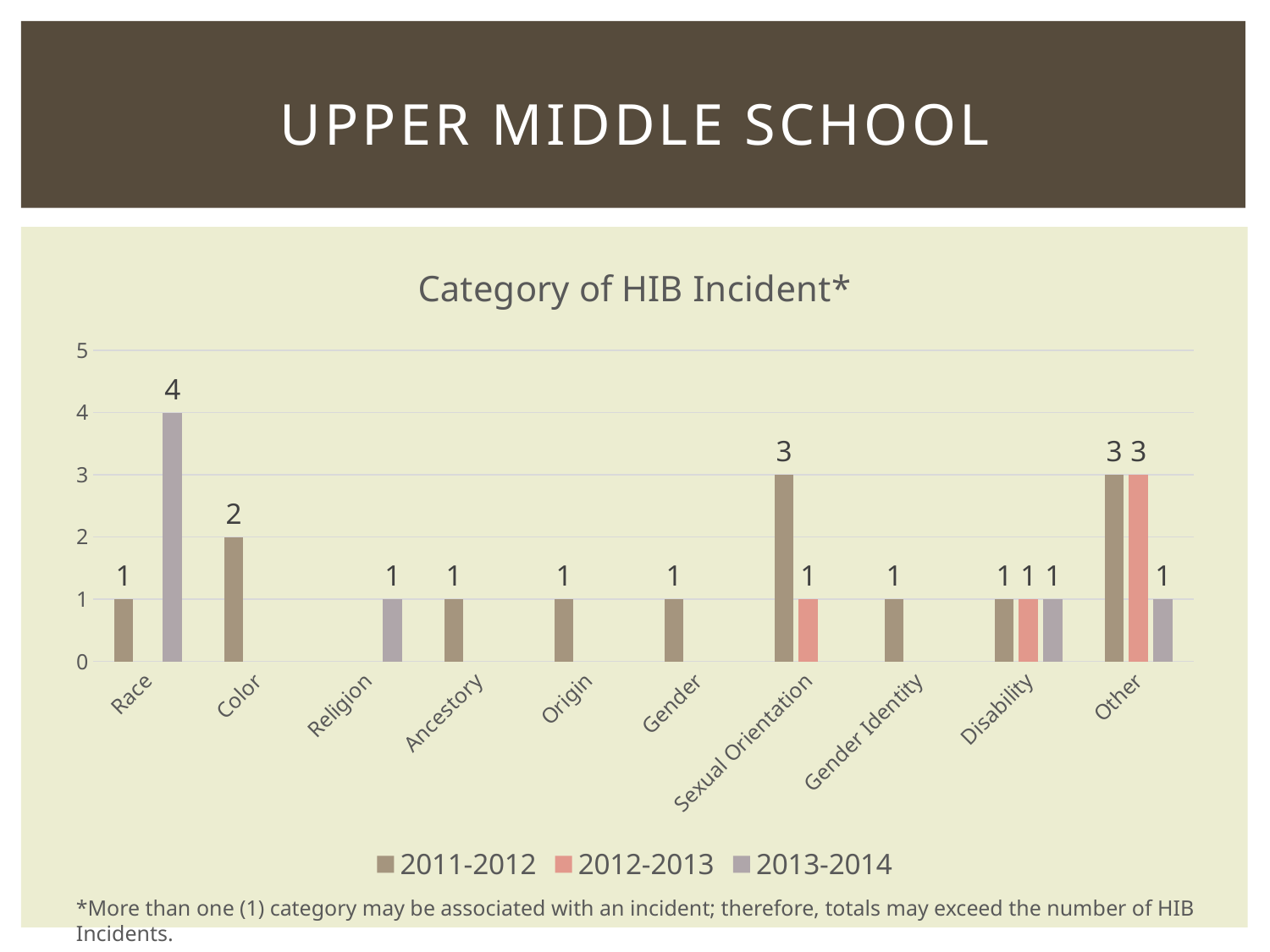
Which is larger: the 2011-2012 value for Sexual Orientation or the 2011-2012 value for Color? Sexual Orientation What is the 2011-2012 value for Sexual Orientation? 3 What is the 2012-2013 value for Other? 3 What is the 2011-2012 value for Color? 2 What kind of chart is shown? Bar chart How many series does the legend list? 3 What is the 2013-2014 value for Race? 4 Which series is shown in pink/red in the legend? 2012-2013 What is the title of the chart? Category of HIB Incident* Which category has the highest 2013-2014 value? Race How many categories are shown on the x axis? 10 What is the difference between the 2013-2014 value for Race and the 2011-2012 value for Race? 3